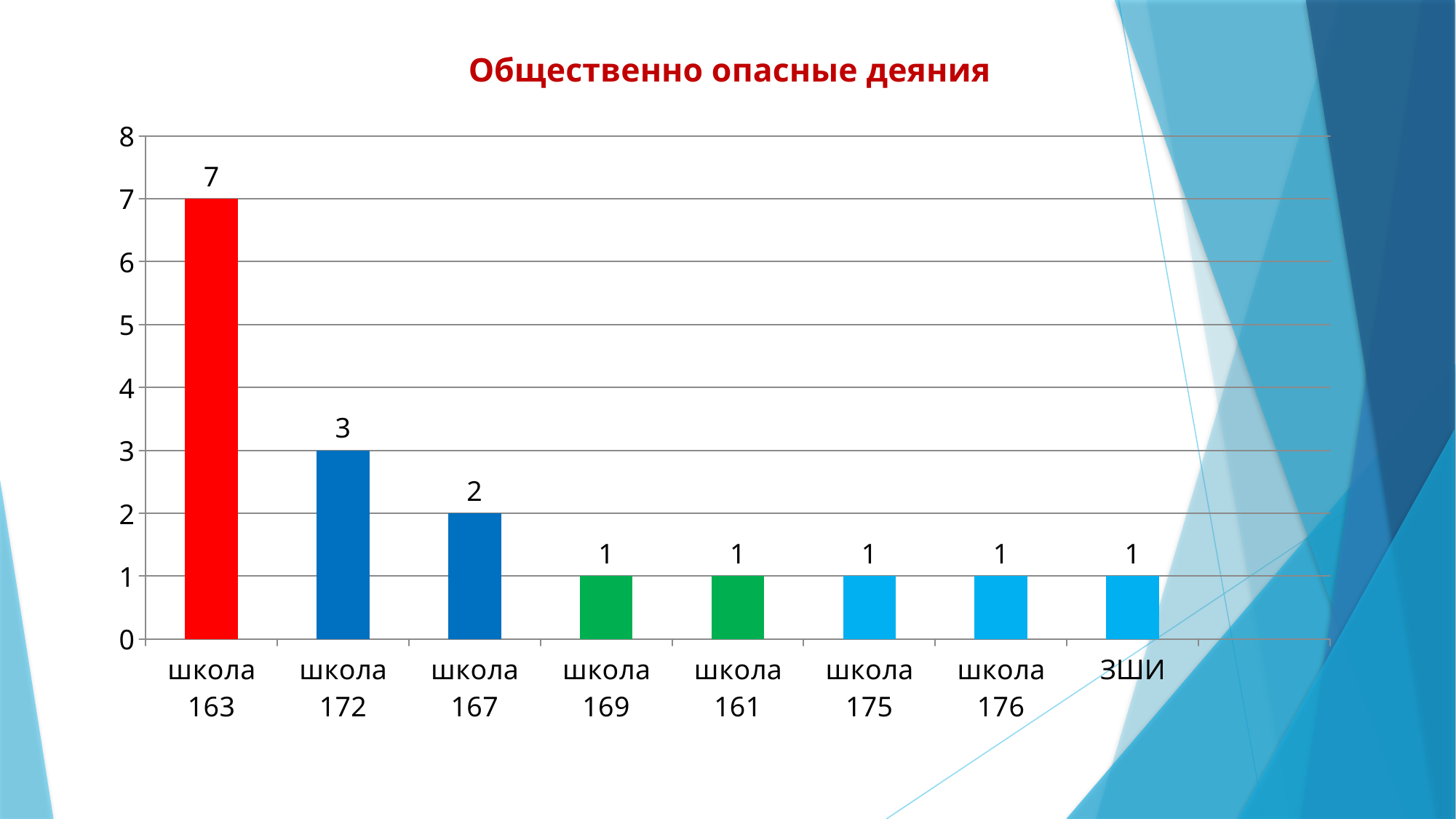
What is the value for ЗШИ? 1 What is the difference between the values for школа 172 and школа 167? 1 What is the title of the chart? Общественно опасные деяния What is the value for школа 172? 3 What kind of chart is shown on the slide? bar chart Which is larger, the value for школа 167 or the value for школа 169? школа 167 What is the value for школа 163? 7 Is the value for школа 163 greater or less than 5? greater What is the value for школа 167? 2 What is the difference between the values for школа 163 and школа 172? 4 Which category has the highest value? школа 163 How many categories are shown on the x axis? 8